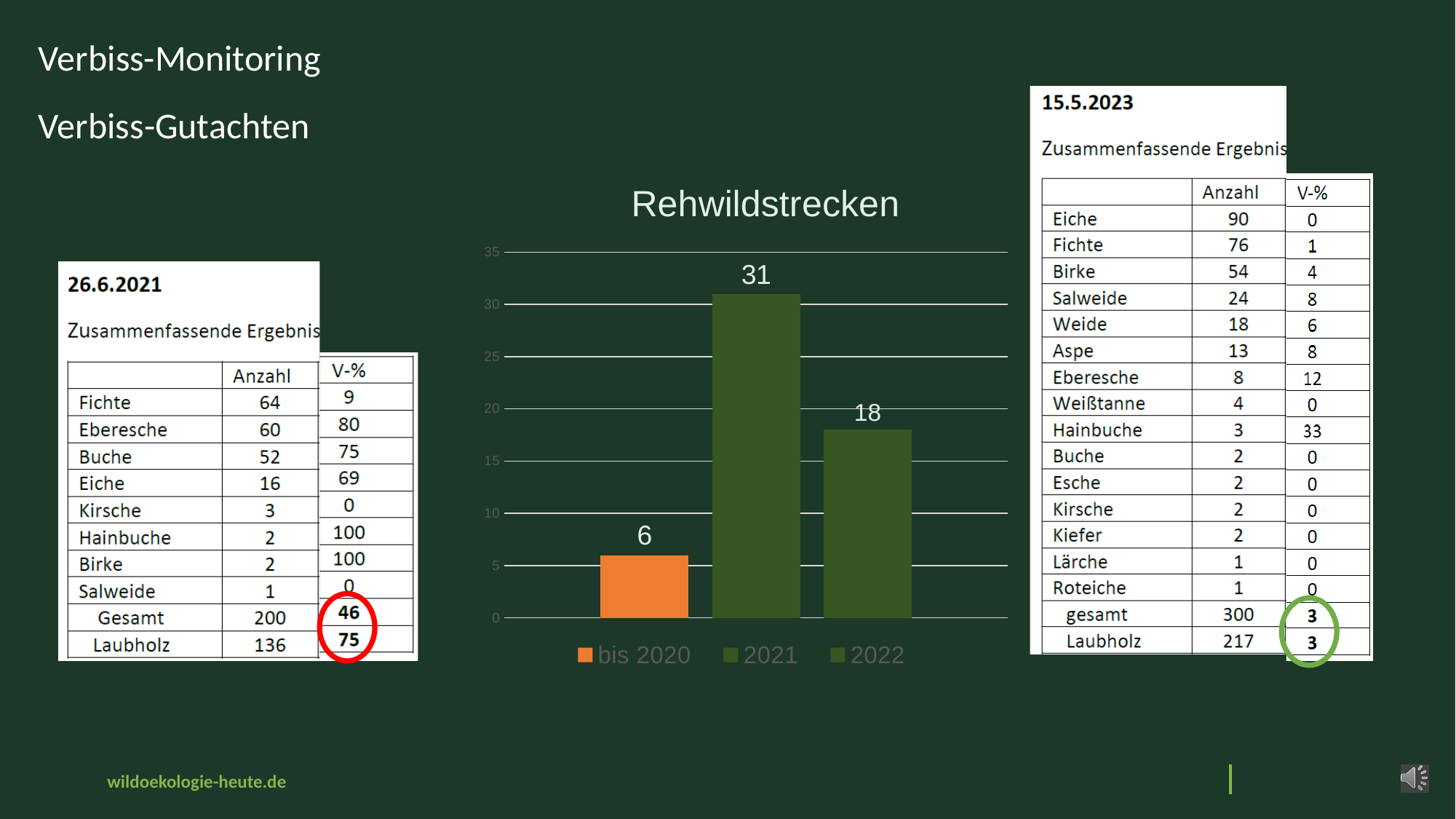
What is the value for 2021 in the Rehwildstrecken chart? 31 What is the difference between the values for 2021 and 2022 in the Rehwildstrecken chart? 13 What type of chart is shown on the slide? bar chart What colour is the bar for 'bis 2020' in the Rehwildstrecken chart? orange What is the value for 2022 in the Rehwildstrecken chart? 18 What is the value for 'bis 2020' in the Rehwildstrecken chart? 6 Which is larger in the Rehwildstrecken chart: the value for 2022 or the value for 'bis 2020'? 2022 Which series has the lowest value in the Rehwildstrecken chart? bis 2020 How many bars are plotted in the Rehwildstrecken chart? 3 Which series has the highest value in the Rehwildstrecken chart? 2021 How many series does the legend of the Rehwildstrecken chart list? 3 What is the title of the chart? Rehwildstrecken